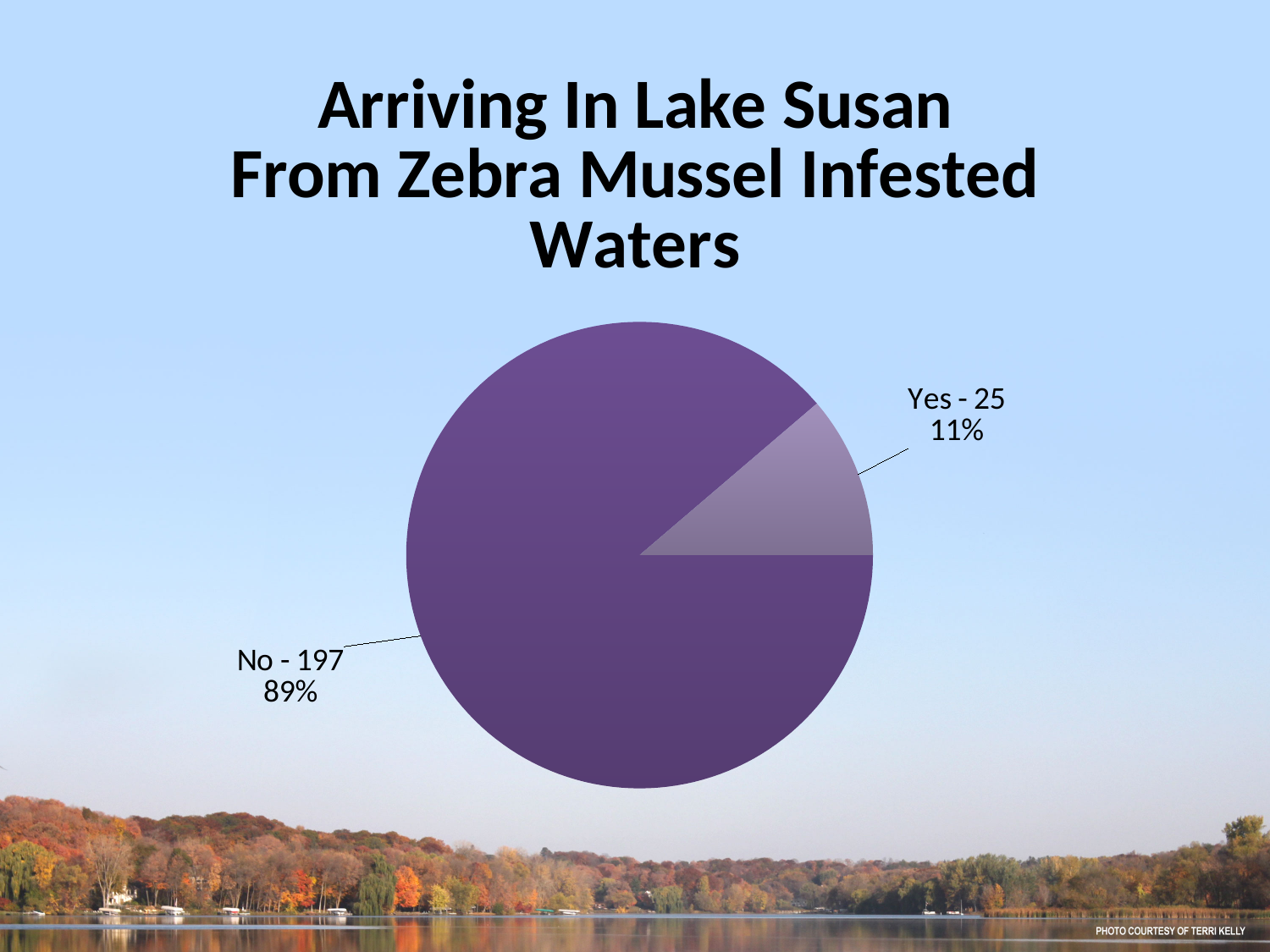
Which is larger, the "Yes" value or the "No" value? No What is the value for the "No" slice? 197 How many slices does the pie chart have? 2 Which slice is the largest? No What is the total of the two slices? 222 What share of the pie does the "Yes" slice represent? 11% What is the value for the "Yes" slice? 25 What kind of chart is shown on the slide? pie chart Which slice is the smallest? Yes What share of the pie does the "No" slice represent? 89% What is the title of the chart? Arriving In Lake Susan From Zebra Mussel Infested Waters What is the difference between the "No" and "Yes" values? 172